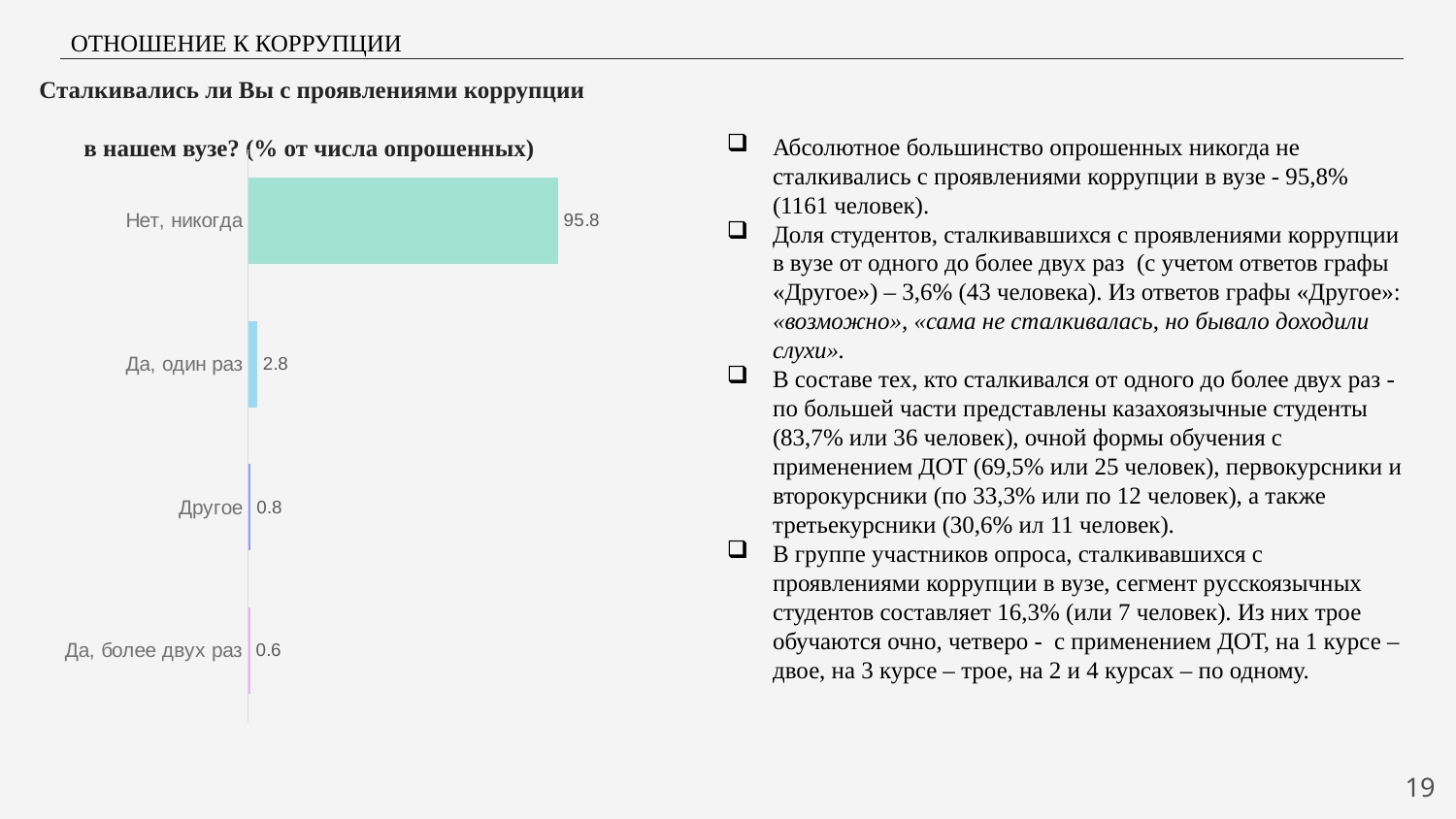
What is the difference between the values for "Нет, никогда" and "Да, один раз"? 93.0 How many categories are shown in the chart? 4 Which category has the highest value? Нет, никогда What is the value for "Да, более двух раз"? 0.6 What is the value for "Да, один раз"? 2.8 What is the value for "Нет, никогда"? 95.8 What kind of chart is shown on the slide? Bar chart Which is larger, the value for "Да, один раз" or the value for "Другое"? Да, один раз Which category has the lowest value? Да, более двух раз What is the value for "Другое"? 0.8 What is the title of the chart? Сталкивались ли Вы с проявлениями коррупции в нашем вузе? (% от числа опрошенных) What is the difference between the values for "Другое" and "Да, более двух раз"? 0.2